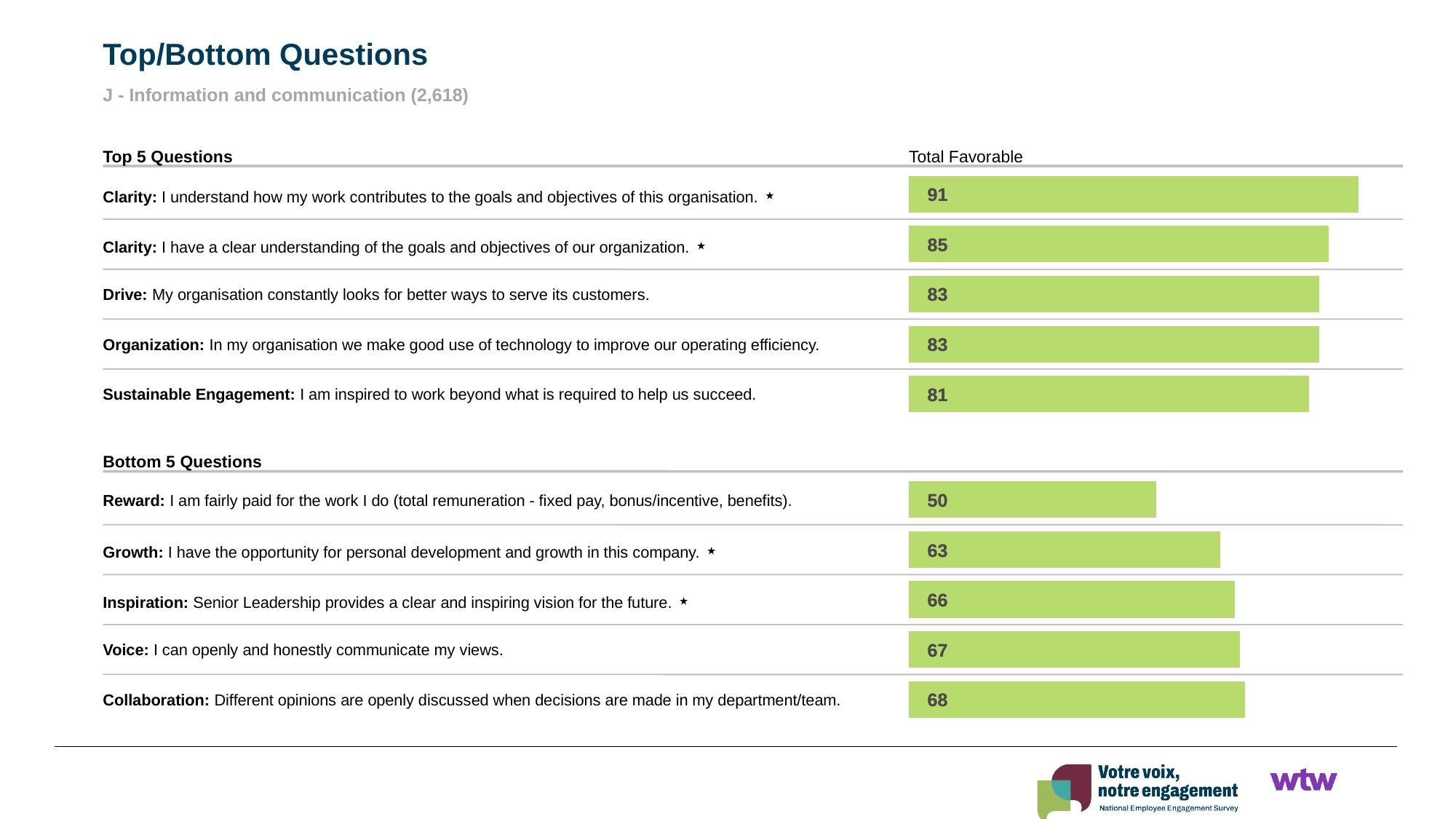
In the Top 5 Questions chart, what is the difference between the Total Favorable values for the two Clarity questions? 6 In the Bottom 5 Questions chart, which has a higher Total Favorable value: Growth or Inspiration? Inspiration How many questions are shown in the Bottom 5 Questions chart? 5 In the Bottom 5 Questions chart, what is the Total Favorable value for "Voice: I can openly and honestly communicate my views"? 67 In the Top 5 Questions chart, what is the Total Favorable value for "Clarity: I understand how my work contributes to the goals and objectives of this organisation"? 91 In the Bottom 5 Questions chart, what is the Total Favorable value for "Reward: I am fairly paid for the work I do"? 50 In the Top 5 Questions chart, what is the Total Favorable value for "Sustainable Engagement: I am inspired to work beyond what is required to help us succeed"? 81 In the Bottom 5 Questions chart, which question has the lowest Total Favorable value? Reward: I am fairly paid for the work I do (total remuneration - fixed pay, bonus/incentive, benefits). In the Top 5 Questions chart, which question has the highest Total Favorable value? Clarity: I understand how my work contributes to the goals and objectives of this organisation. In the Bottom 5 Questions chart, what is the difference between the Total Favorable values for Collaboration and Reward? 18 What is the subtitle shown under the slide title "Top/Bottom Questions"? J - Information and communication (2,618) What kind of chart is used to show the Total Favorable values on this slide? Bar chart